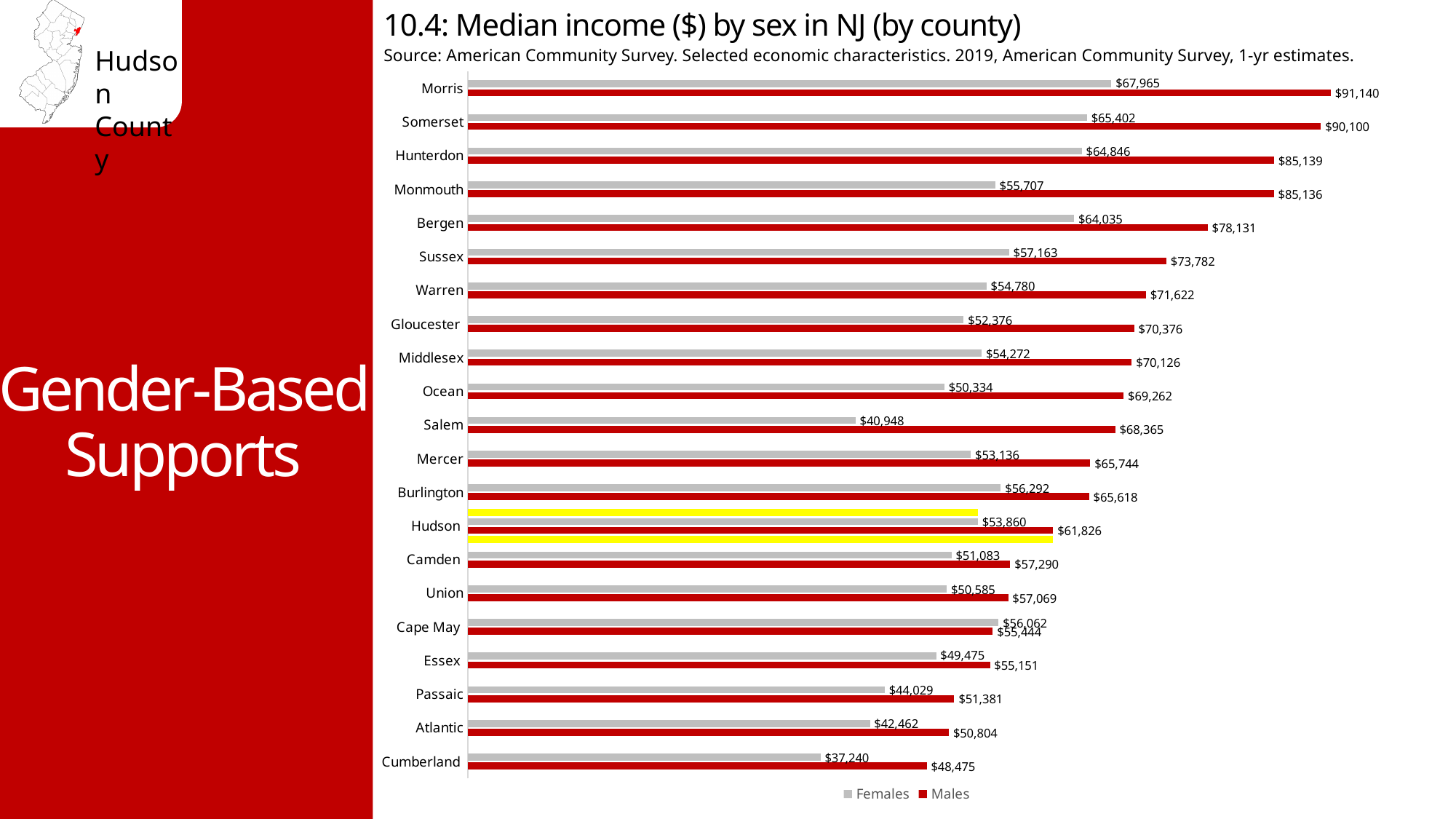
What is the median income for males in Cumberland County? $48,475 What is the median income for males in Hudson County? $61,826 What type of chart is shown on the slide? Bar chart Which county has the highest median income for males? Morris Which county has the lowest median income for females? Cumberland How many series does the legend list? 2 In Cape May County, which is higher: the median income for females or for males? Females What is the difference between male and female median income in Hudson County? $7,966 What is the median income for females in Morris County? $67,965 How many counties are shown on the chart? 21 What is the median income for females in Hudson County? $53,860 Which county's bars are highlighted in yellow on the chart? Hudson